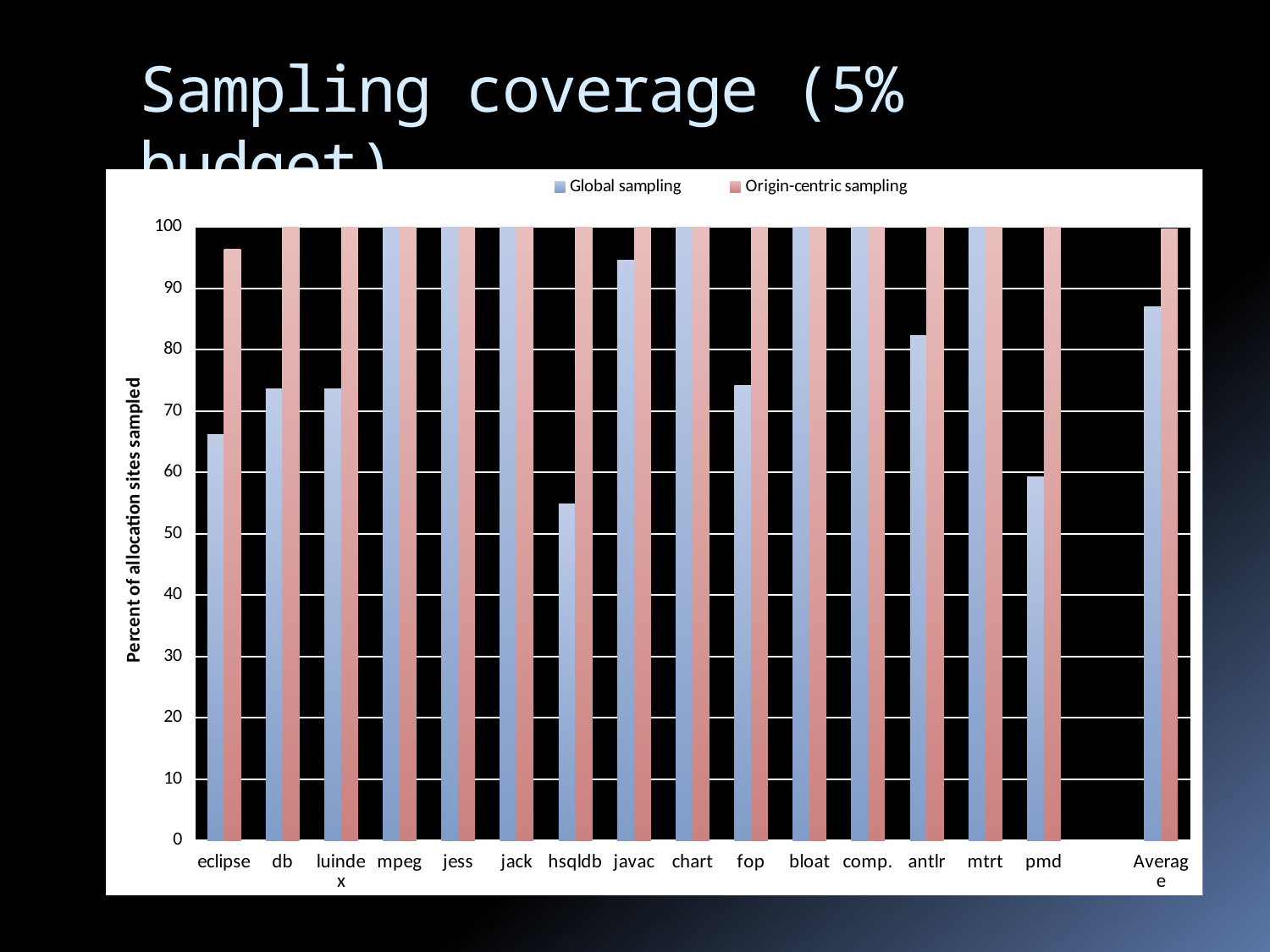
Which category has the lowest Global sampling value? hsqldb Is the Global sampling value for eclipse greater or less than 60? greater How many categories are shown along the x axis? 16 What is the label on the vertical axis? Percent of allocation sites sampled Is the Global sampling value for Average greater or less than 80? greater What kind of chart is shown on the slide? bar chart Is the Global sampling value for hsqldb greater or less than 60? less For eclipse, which is larger: Global sampling or Origin-centric sampling? Origin-centric sampling Which category has the lowest Origin-centric sampling value? eclipse Which has the larger Global sampling value, db or hsqldb? db How many series does the legend list? 2